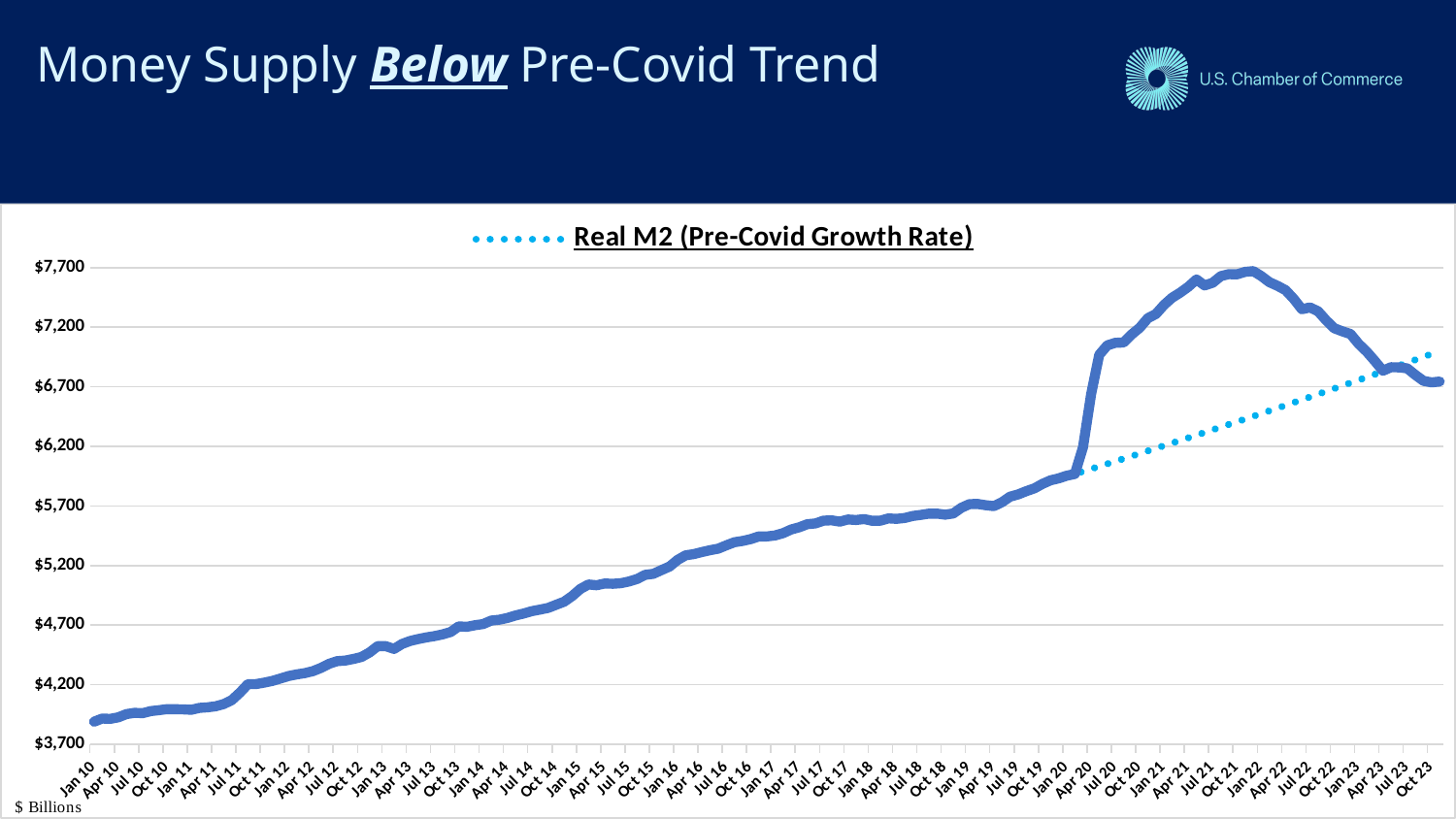
What is the title of the slide's chart? Money Supply Below Pre-Covid Trend Is the value of the solid line at Jul 20 greater or less than $6,700? greater What unit is the y axis measured in, according to the note at the bottom left? $ Billions Is the value of the solid line at Jan 20 greater or less than $6,200? less Is the value of the solid line at Jan 15 greater or less than $4,700? greater Do the values of the solid line rise or fall from Jan 22 to Oct 23? fall At which x-axis date is the solid line at its lowest value? Jan 10 At Oct 23, is the solid line above or below the dotted trend line? below Do the values of the solid line generally rise or fall from Jan 10 to Jan 20? rise What kind of chart is shown on the slide? line chart